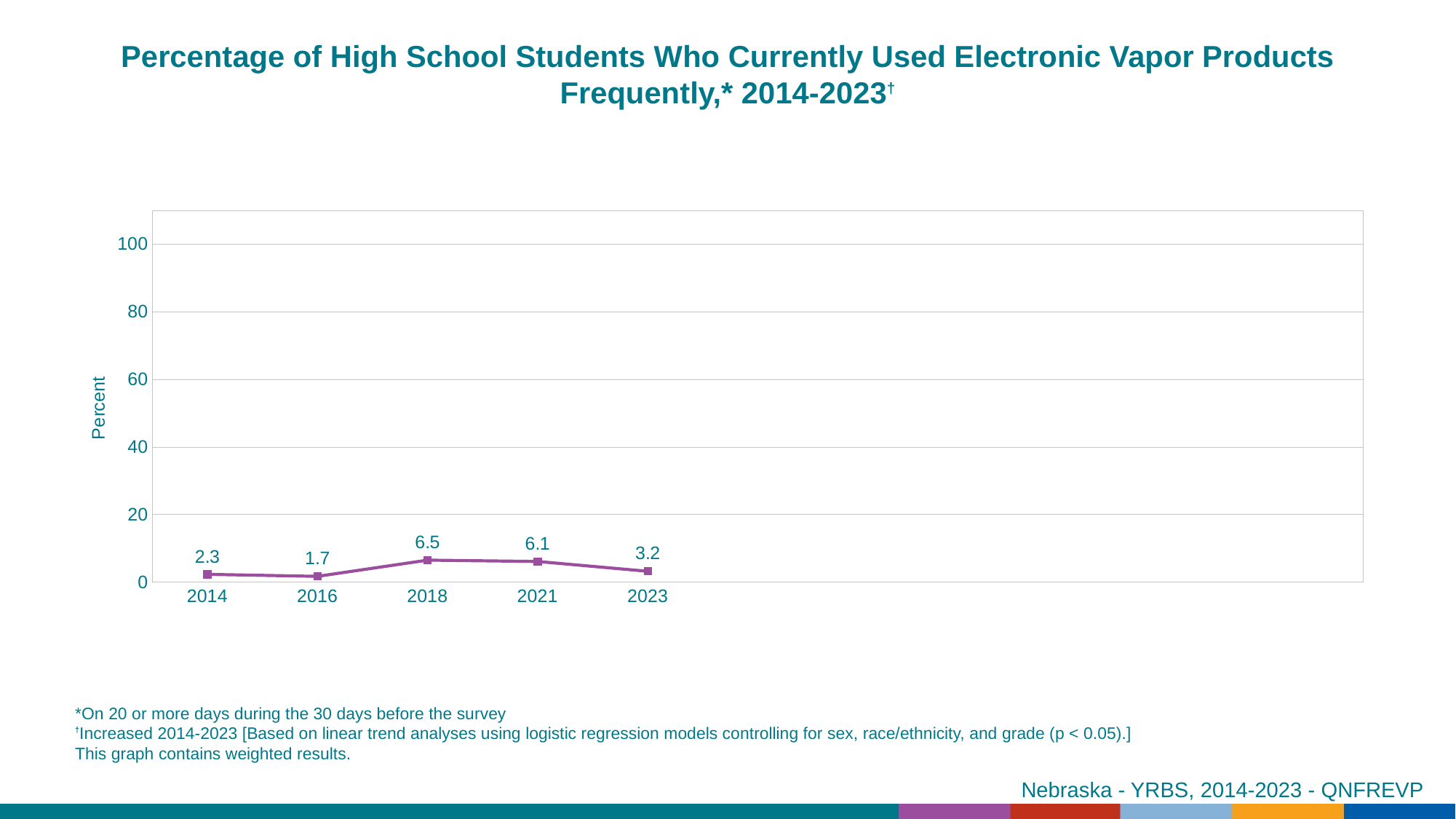
What is the difference between the values for 2021 and 2023? 2.9 Which is larger, the value for 2014 or the value for 2023? 2023 Which year has the lowest value? 2016 How many years are plotted on the chart? 5 Is the value for 2021 greater or less than 20? less What is the label of the y axis? Percent What kind of chart is shown on the slide? line chart What is the difference between the values for 2018 and 2016? 4.8 Which year has the highest value? 2018 What is the value for 2023? 3.2 What is the value for 2018? 6.5 What is the value for 2014? 2.3